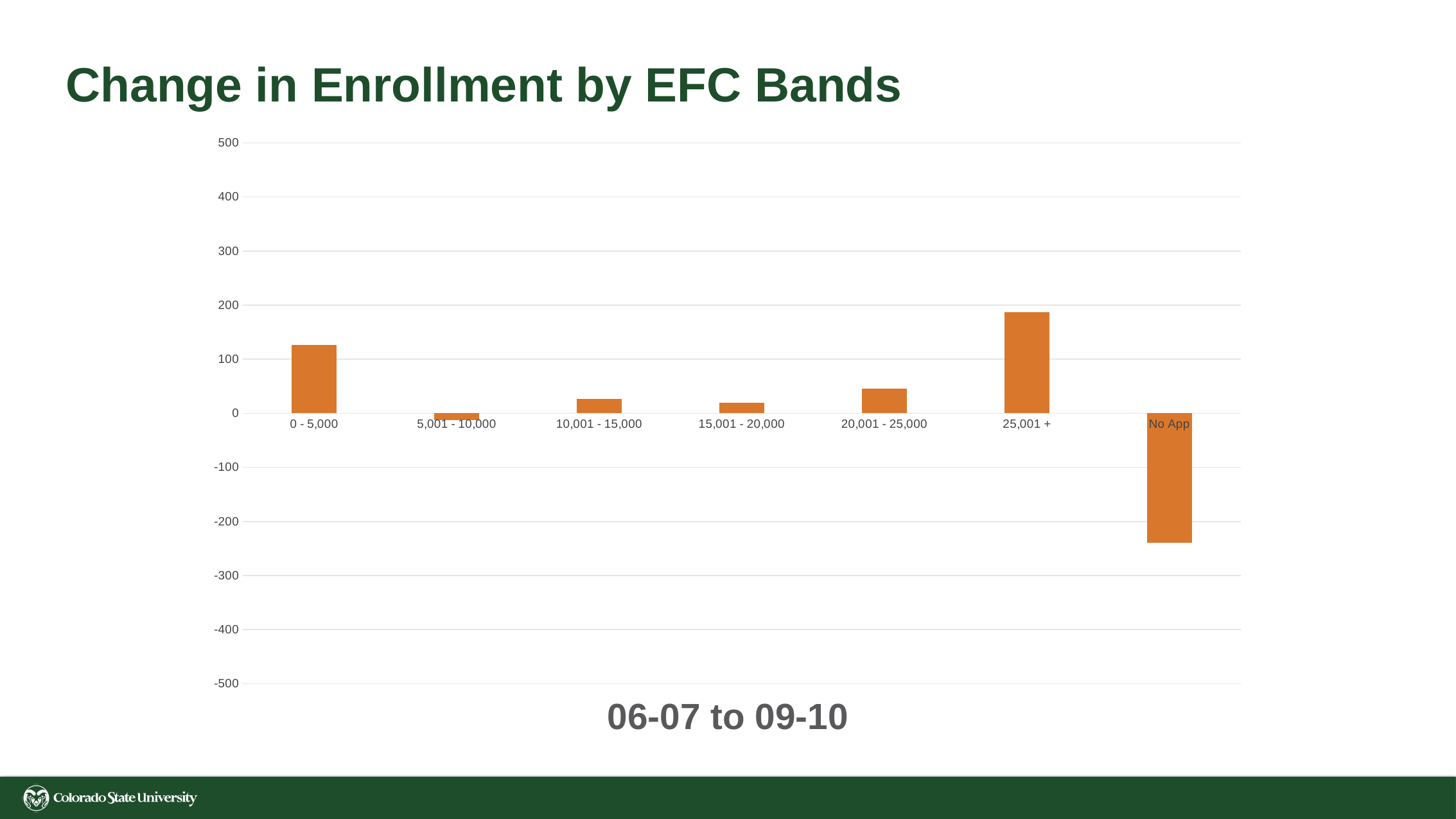
Is the value for 0 - 5,000 greater or less than 100? greater How many EFC band categories are plotted on the chart? 7 Is the value for 25,001 + greater or less than 200? less Is the value for 20,001 - 25,000 greater or less than 100? less Which category has the highest change in enrollment? 25,001 + Which is larger, the value for 5,001 - 10,000 or the value for 10,001 - 15,000? 10,001 - 15,000 Which is larger, the value for 0 - 5,000 or the value for 20,001 - 25,000? 0 - 5,000 What kind of chart is shown on the slide? bar chart Which category has the lowest change in enrollment? No App What period is shown in the label below the chart's x axis? 06-07 to 09-10 What is the title of the chart? Change in Enrollment by EFC Bands